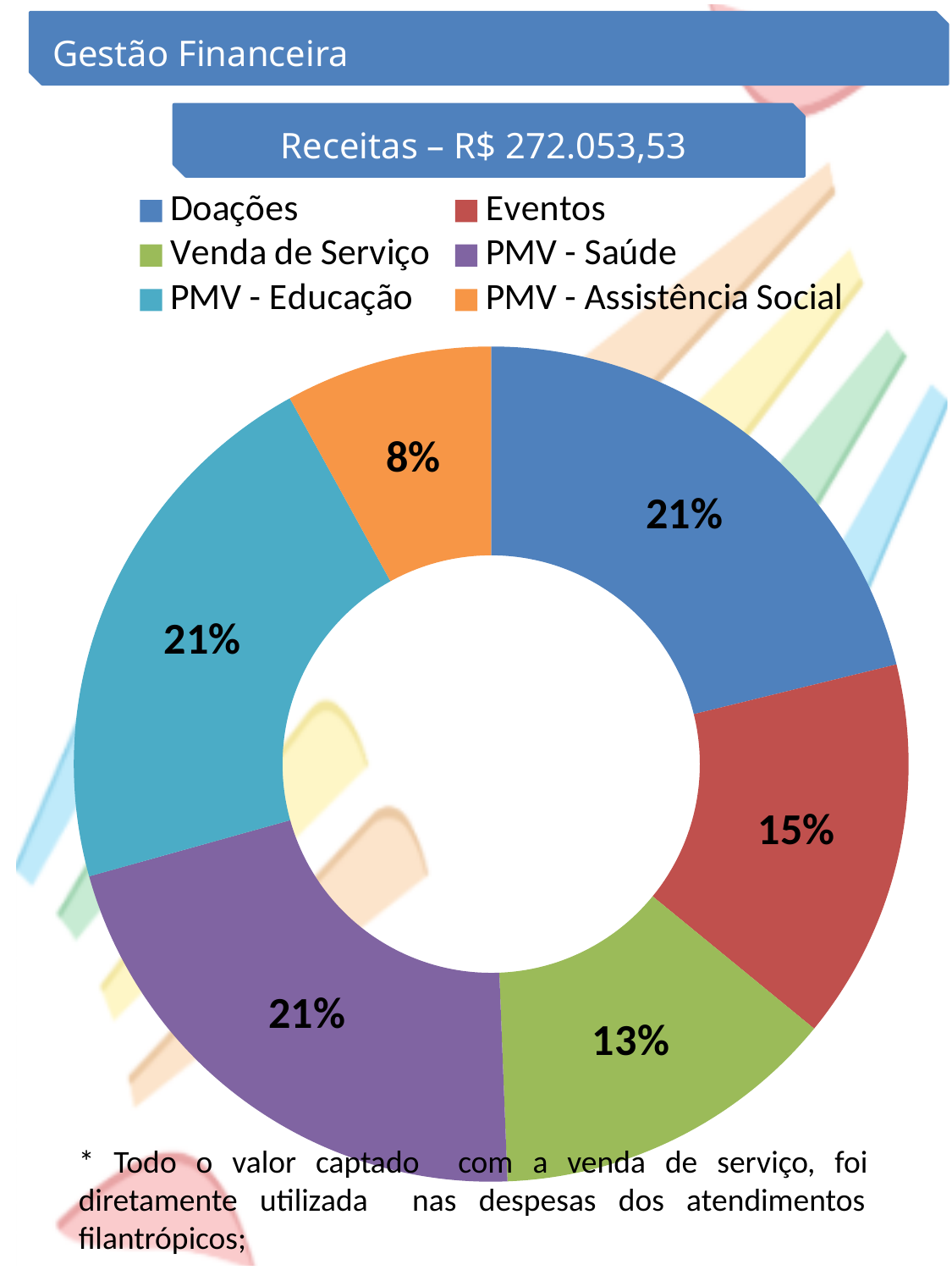
What total value of receitas is stated in the chart's heading? R$ 272.053,53 Which category has the smallest share of the chart? PMV - Assistência Social Which is larger, the share for Eventos or the share for Venda de Serviço? Eventos What share of receitas comes from Doações? 21% What percentage is shown for PMV - Saúde? 21% What kind of chart is shown on the slide? Doughnut chart What percentage is shown for Eventos? 15% What is the difference in percentage points between Doações and PMV - Assistência Social? 13 What share does PMV - Assistência Social represent? 8% What percentage is shown for Venda de Serviço? 13% What is the difference in percentage points between Eventos and Venda de Serviço? 2 How many categories does the chart show? 6